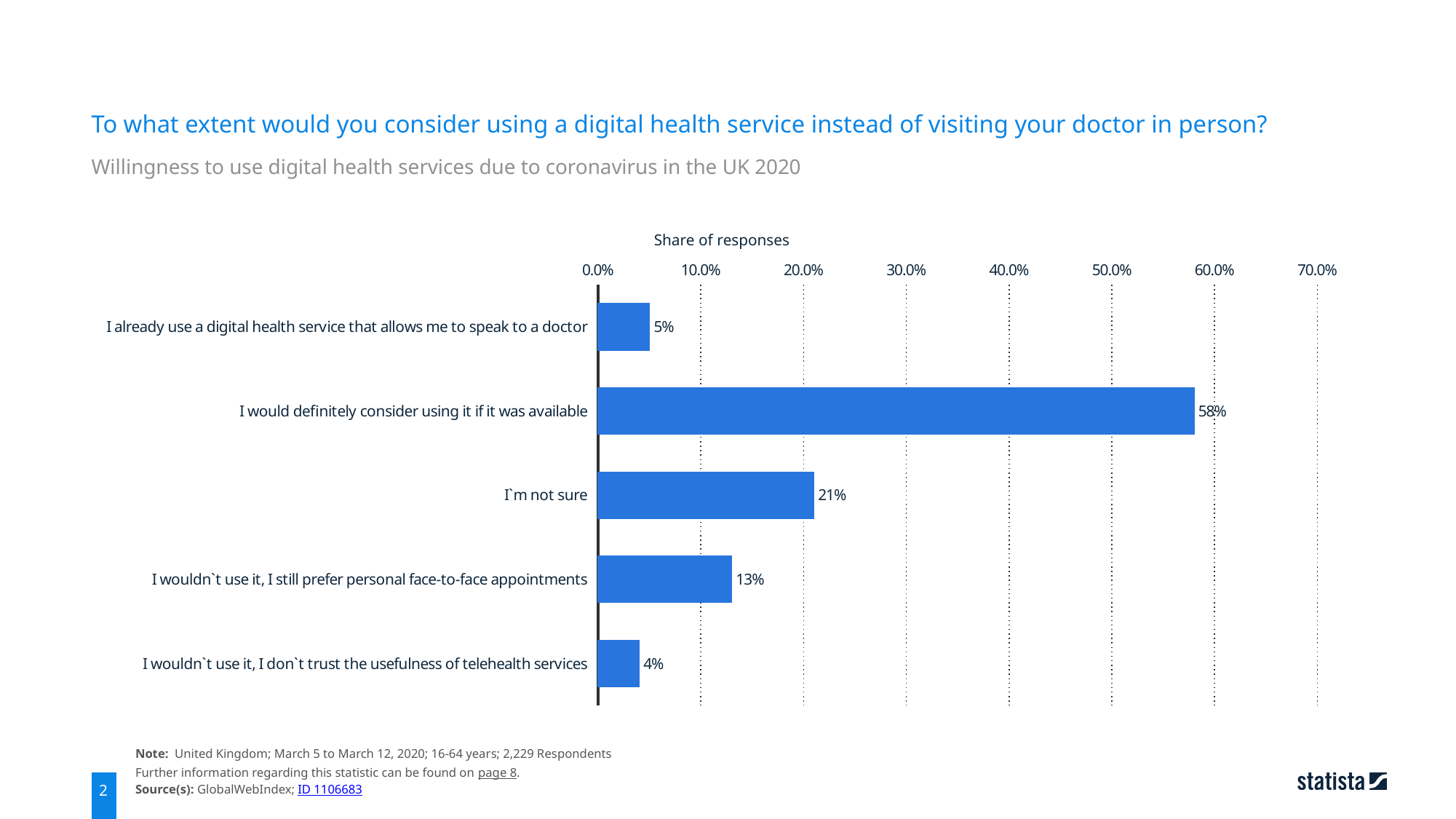
What share of responses is shown for "I would definitely consider using it if it was available"? 58% How many response categories are shown in the chart? 5 Is the value for "I would definitely consider using it if it was available" greater or less than 50.0%? greater What share of responses is shown for "I wouldn`t use it, I still prefer personal face-to-face appointments"? 13% What kind of chart is shown on the slide? Bar chart Which response category has the lowest share of responses? I wouldn`t use it, I don`t trust the usefulness of telehealth services What is the label of the horizontal axis of the chart? Share of responses What share of responses is shown for "I`m not sure"? 21% What share of responses is shown for "I already use a digital health service that allows me to speak to a doctor"? 5% What is the difference in share of responses between "I would definitely consider using it if it was available" and "I`m not sure"? 37% Which has a larger share of responses: "I`m not sure" or "I wouldn`t use it, I still prefer personal face-to-face appointments"? I`m not sure Which response category has the highest share of responses? I would definitely consider using it if it was available